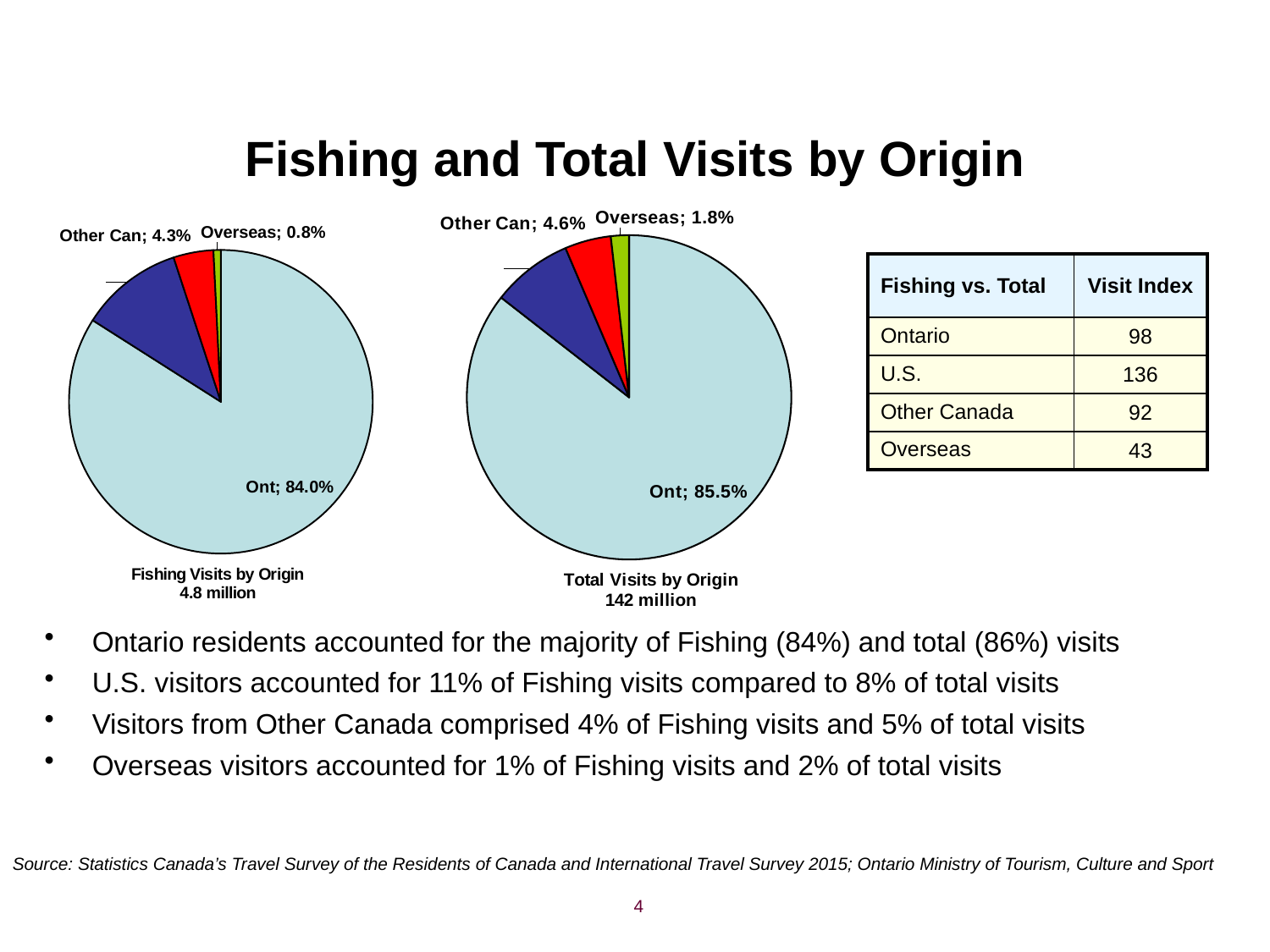
What type of chart is used for Total Visits by Origin? Pie chart What is the difference in percentage points between the Ont share in the Total Visits by Origin chart and the Ont share in the Fishing Visits by Origin chart? 1.5 percentage points In the Fishing Visits by Origin chart, what share is labelled for Overseas? 0.8% How many slices does the Fishing Visits by Origin pie chart have? 4 In the Total Visits by Origin chart, what share of visits is labelled for Ont? 85.5% In the Total Visits by Origin chart, what share is labelled for Other Can? 4.6% In the Fishing Visits by Origin chart, what share of visits is labelled for Ont? 84.0% In the Total Visits by Origin chart, which origin has the smallest slice? Overseas In the Fishing Visits by Origin chart, what share is labelled for Other Can? 4.3% Is the Other Can share larger in the Fishing Visits by Origin chart or in the Total Visits by Origin chart? Total Visits by Origin In the Total Visits by Origin chart, what share is labelled for Overseas? 1.8% In the Fishing Visits by Origin chart, which origin has the largest slice? Ont